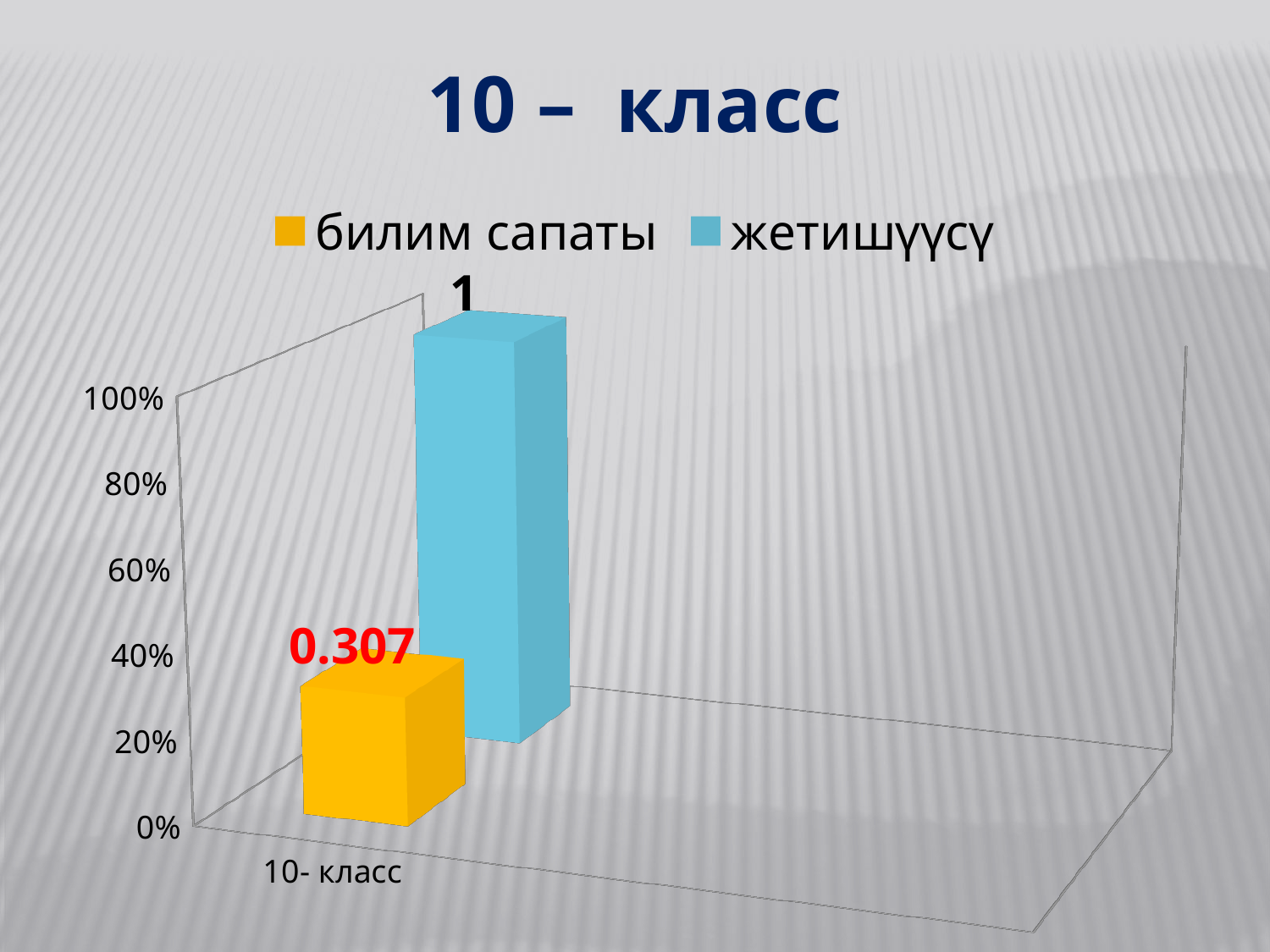
What colour is the жетишүүсү bar? blue What is the value of the жетишүүсү bar for 10- класс? 1 Which series has the lower value for 10- класс? билим сапаты Is the билим сапаты value larger or smaller than the жетишүүсү value? smaller Is the value for билим сапаты greater or less than 40%? less What is the title of the slide? 10 – класс How many categories are shown on the x axis? 1 What is the difference between the жетишүүсү value and the билим сапаты value? 0.693 What is the value of the билим сапаты bar for 10- класс? 0.307 Which series has the higher value for 10- класс? жетишүүсү How many series does the legend list? 2 What kind of chart is shown on the slide? bar chart